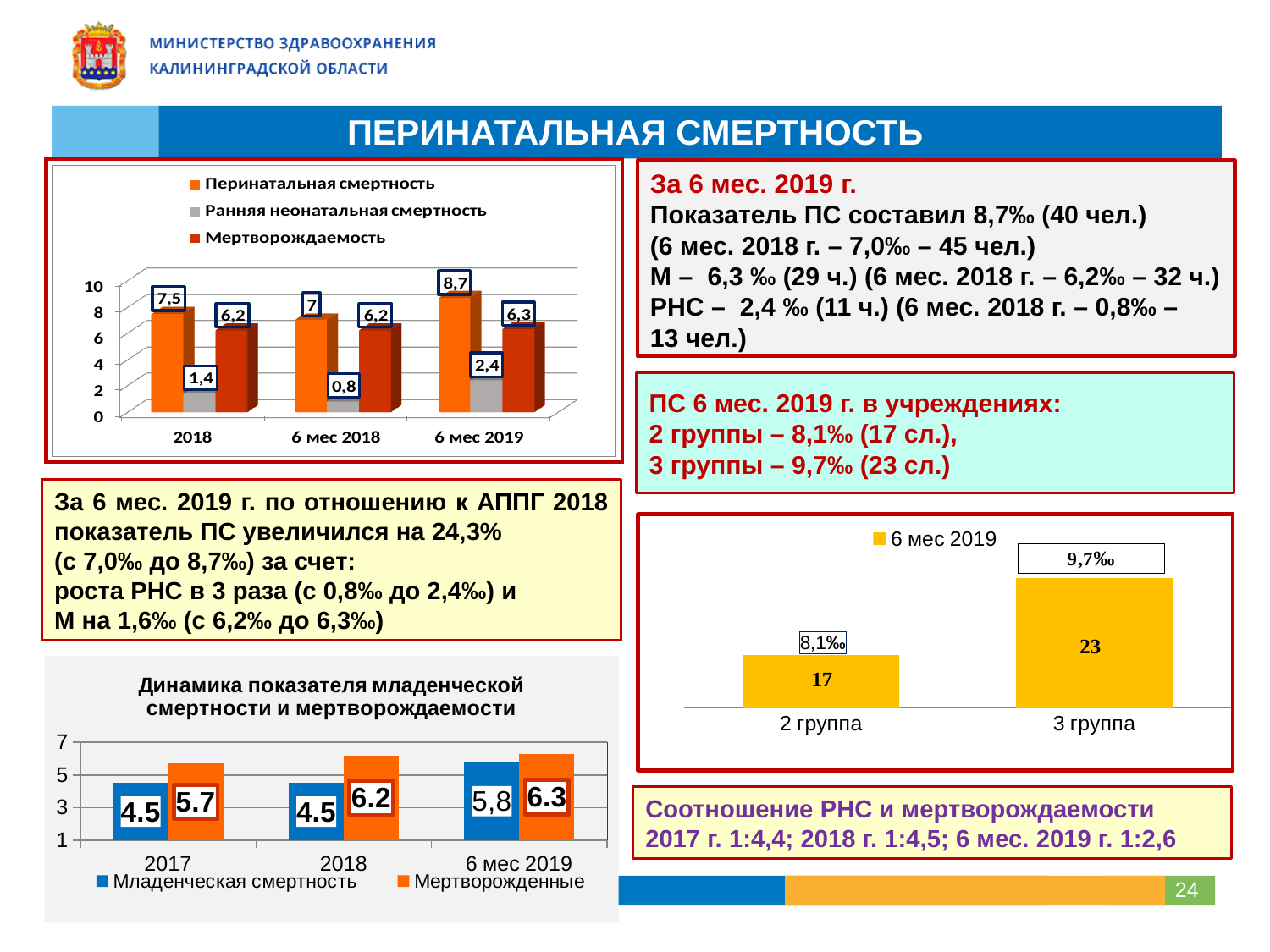
In the top-left chart, what is the value of Ранняя неонатальная смертность for 6 мес 2018? 0,8 In the top-left chart, what is the difference between Ранняя неонатальная смертность for 6 мес 2019 and for 6 мес 2018? 1,6 In the top-left chart, which category has the highest value for Перинатальная смертность? 6 мес 2019 In the top-left chart, what is the value of Перинатальная смертность for 6 мес 2019? 8,7 In the top-left chart, is the value of Мертворождаемость for 2018 greater or less than Ранняя неонатальная смертность for 2018? greater In the bottom-right chart, what is the value for 3 группа? 9,7‰ In the chart titled 'Динамика показателя младенческой смертности и мертворождаемости', how many categories are on the x axis? 3 What kind of chart is the bottom-right chart? bar chart How many series does the legend of the top-left chart list? 3 In the chart titled 'Динамика показателя младенческой смертности и мертворождаемости', what is the value of Мертворожденные for 2018? 6.2 In the chart titled 'Динамика показателя младенческой смертности и мертворождаемости', what is the value of Младенческая смертность for 6 мес 2019? 5,8 In the chart titled 'Динамика показателя младенческой смертности и мертворождаемости', does the Мертворожденные series rise or fall from 2017 to 6 мес 2019? rise